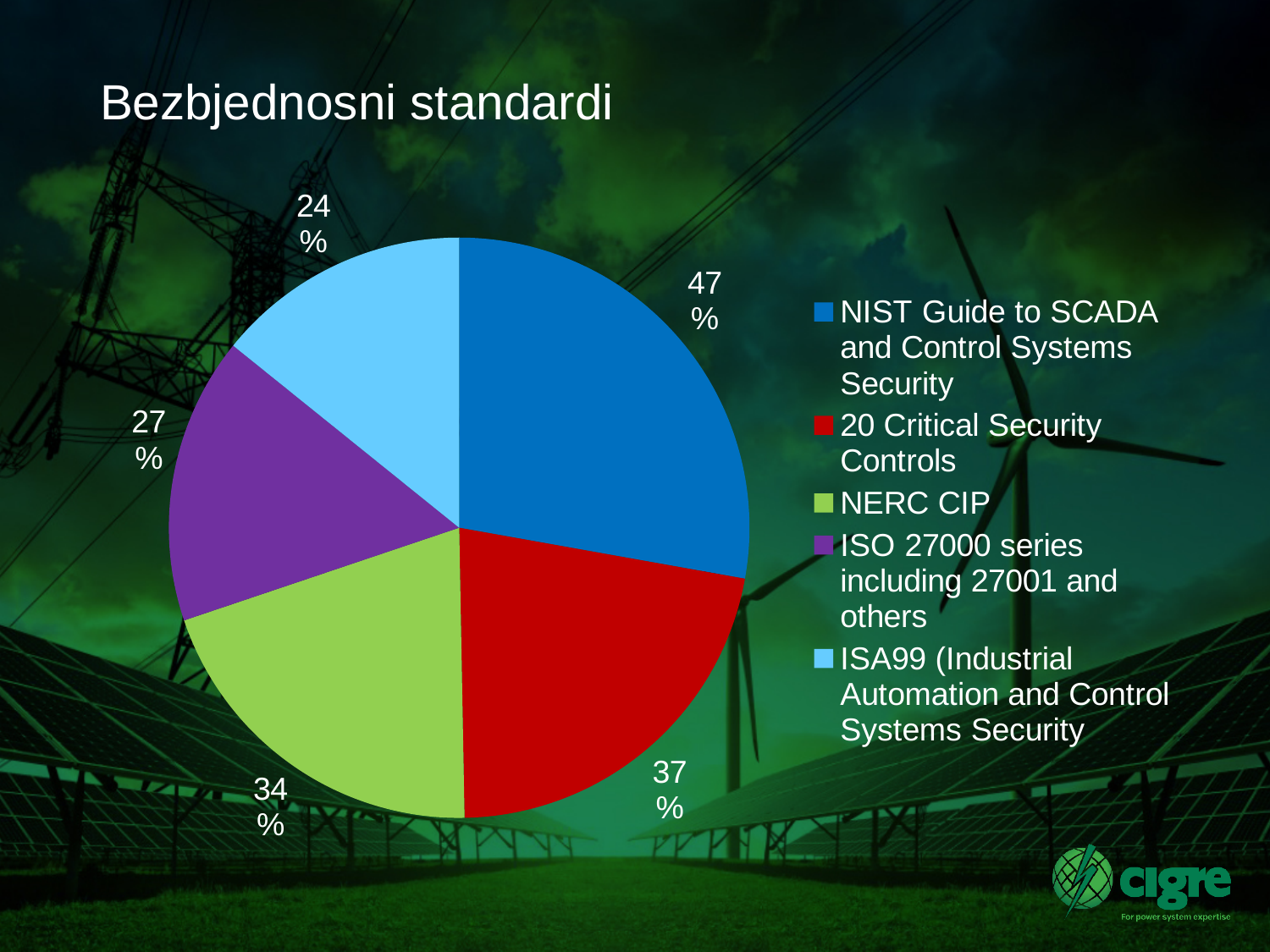
What is the value labelled for NIST Guide to SCADA and Control Systems Security? 47% What is the value labelled for NERC CIP? 34% What is the value labelled for ISA99 (Industrial Automation and Control Systems Security)? 24% What is the title of the slide containing the pie chart? Bezbjednosni standardi What is the value labelled for ISO 27000 series including 27001 and others? 27% Which is larger, the value for NERC CIP or the value for ISO 27000 series including 27001 and others? NERC CIP Which category has the smallest slice of the pie? ISA99 (Industrial Automation and Control Systems Security How many categories does the pie chart show? 5 What is the difference between the values for NIST Guide to SCADA and Control Systems Security and 20 Critical Security Controls? 10% Which category has the largest slice of the pie? NIST Guide to SCADA and Control Systems Security What type of chart is shown on the slide? pie chart What is the value labelled for 20 Critical Security Controls? 37%